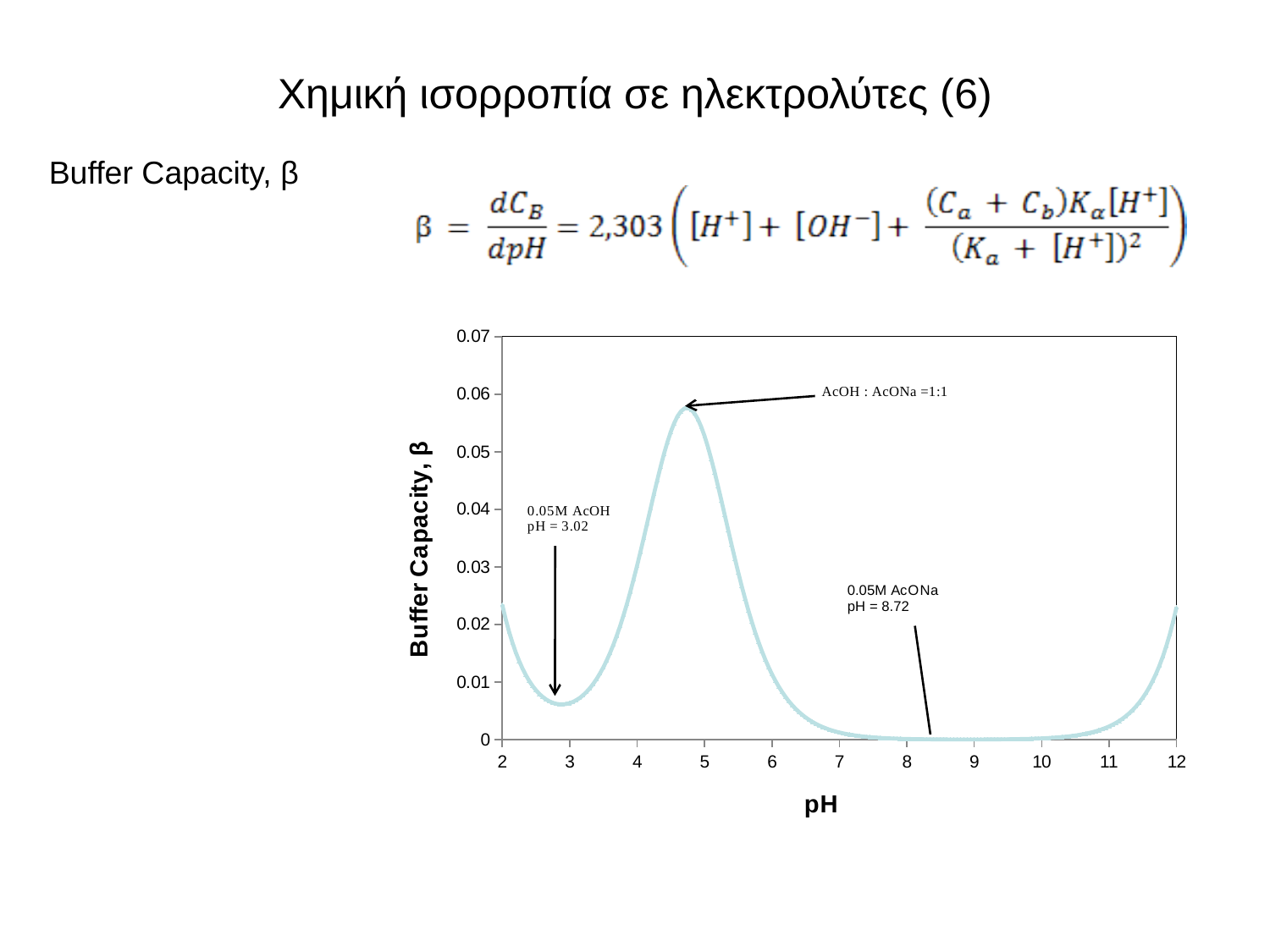
What is the label of the y axis of the chart? Buffer Capacity, β Is the buffer capacity at pH 10 greater or less than 0.01? less Is the buffer capacity at pH 3 greater or less than 0.01? less Does the buffer capacity rise or fall as pH increases from 10 to 12? rise Is the buffer capacity at pH 5 greater or less than 0.04? greater Which annotated point on the curve has the highest buffer capacity? AcOH : AcONa = 1:1 Does the buffer capacity rise or fall as pH increases from 5 to 7? fall Which annotated solution has the lowest buffer capacity, 0.05M AcOH or 0.05M AcONa? 0.05M AcONa What kind of chart is shown on the slide? line chart What is the label of the x axis of the chart? pH